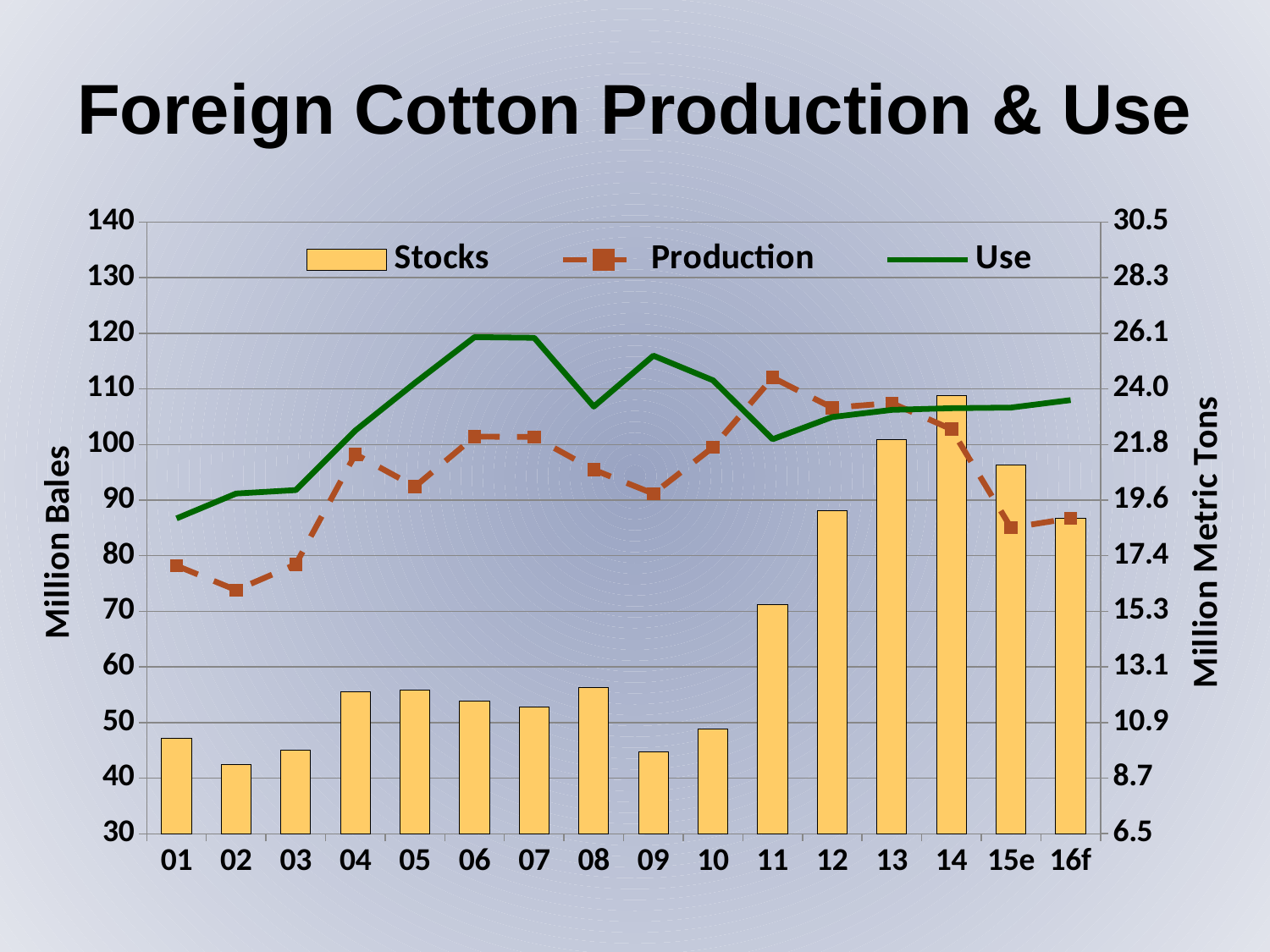
Which year has larger Stocks, 13 or 14? 14 How many years are shown on the x axis? 16 Is the Stocks value for 12 greater or less than 80 million bales? greater In which year does Production reach its highest point? 11 Is the Stocks value for 11 greater or less than 80 million bales? less What are the three series named in the legend? Stocks, Production, Use Is the Stocks value for 01 greater or less than 50 million bales? less In which year are Stocks lowest? 02 What kind of chart is this? Combination bar and line chart How many series does the legend list? 3 Do Stocks rise or fall from 11 to 14? rise In which year are Stocks highest? 14